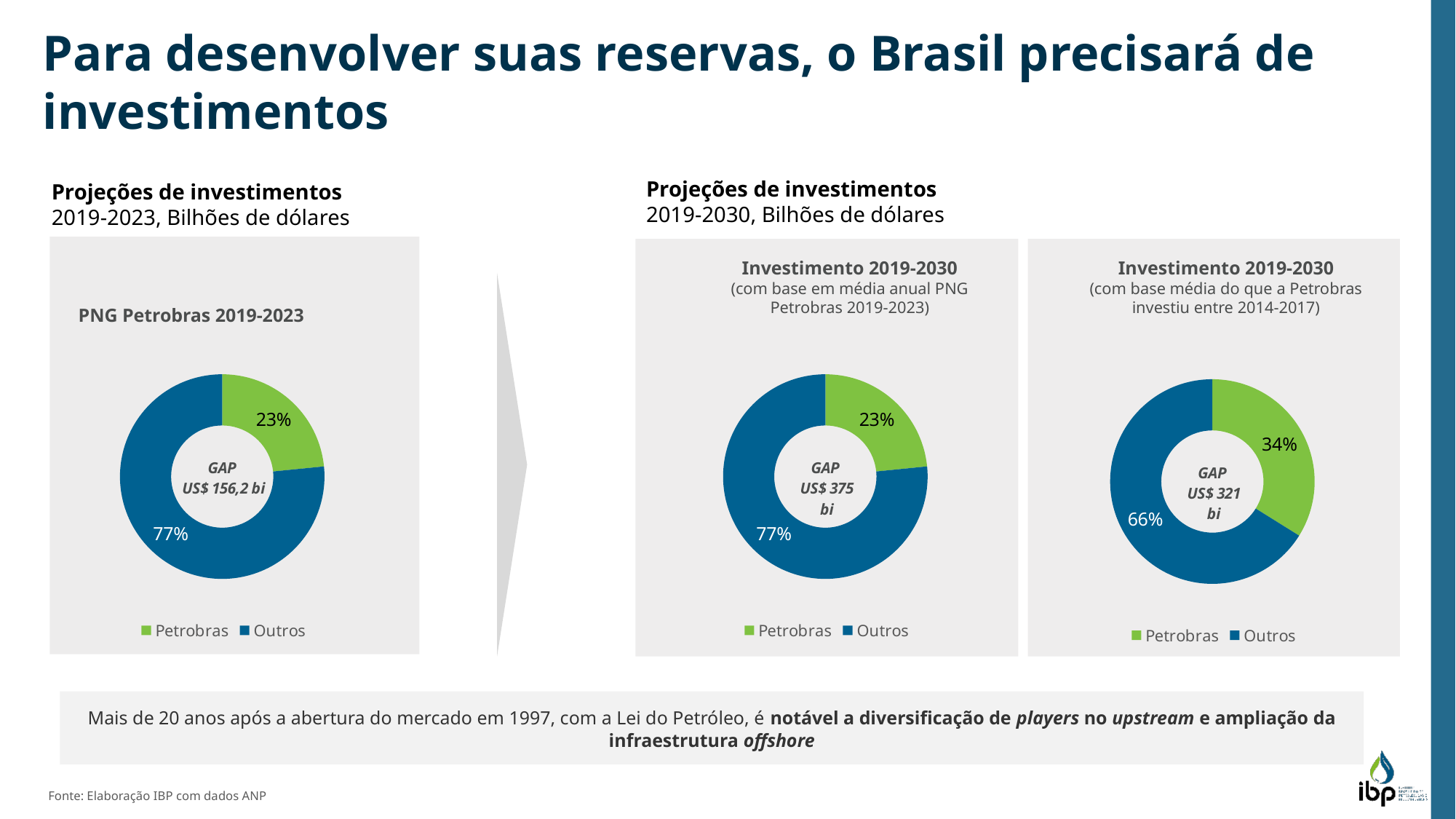
In the right chart 'Investimento 2019-2030 (com base média do que a Petrobras investiu entre 2014-2017)', which slice is larger, Petrobras or Outros? Outros In the right chart 'Investimento 2019-2030 (com base média do que a Petrobras investiu entre 2014-2017)', what share is Outros? 66% In the left chart titled 'PNG Petrobras 2019-2023', what GAP value is printed in the centre of the donut? US$ 156,2 bi In the left chart titled 'PNG Petrobras 2019-2023', what share of the donut is Petrobras? 23% In the right chart 'Investimento 2019-2030 (com base média do que a Petrobras investiu entre 2014-2017)', what GAP value is printed in the centre? US$ 321 bi In the left chart titled 'PNG Petrobras 2019-2023', what share of the donut is Outros? 77% In the right chart 'Investimento 2019-2030 (com base média do que a Petrobras investiu entre 2014-2017)', what is the difference in percentage points between Outros and Petrobras? 32 percentage points How many entries does the legend of the middle chart 'Investimento 2019-2030 (com base em média anual PNG Petrobras 2019-2023)' list? 2 What kind of chart is the left chart titled 'PNG Petrobras 2019-2023'? Donut (pie) chart In the middle chart 'Investimento 2019-2030 (com base em média anual PNG Petrobras 2019-2023)', what GAP value is printed in the centre? US$ 375 bi